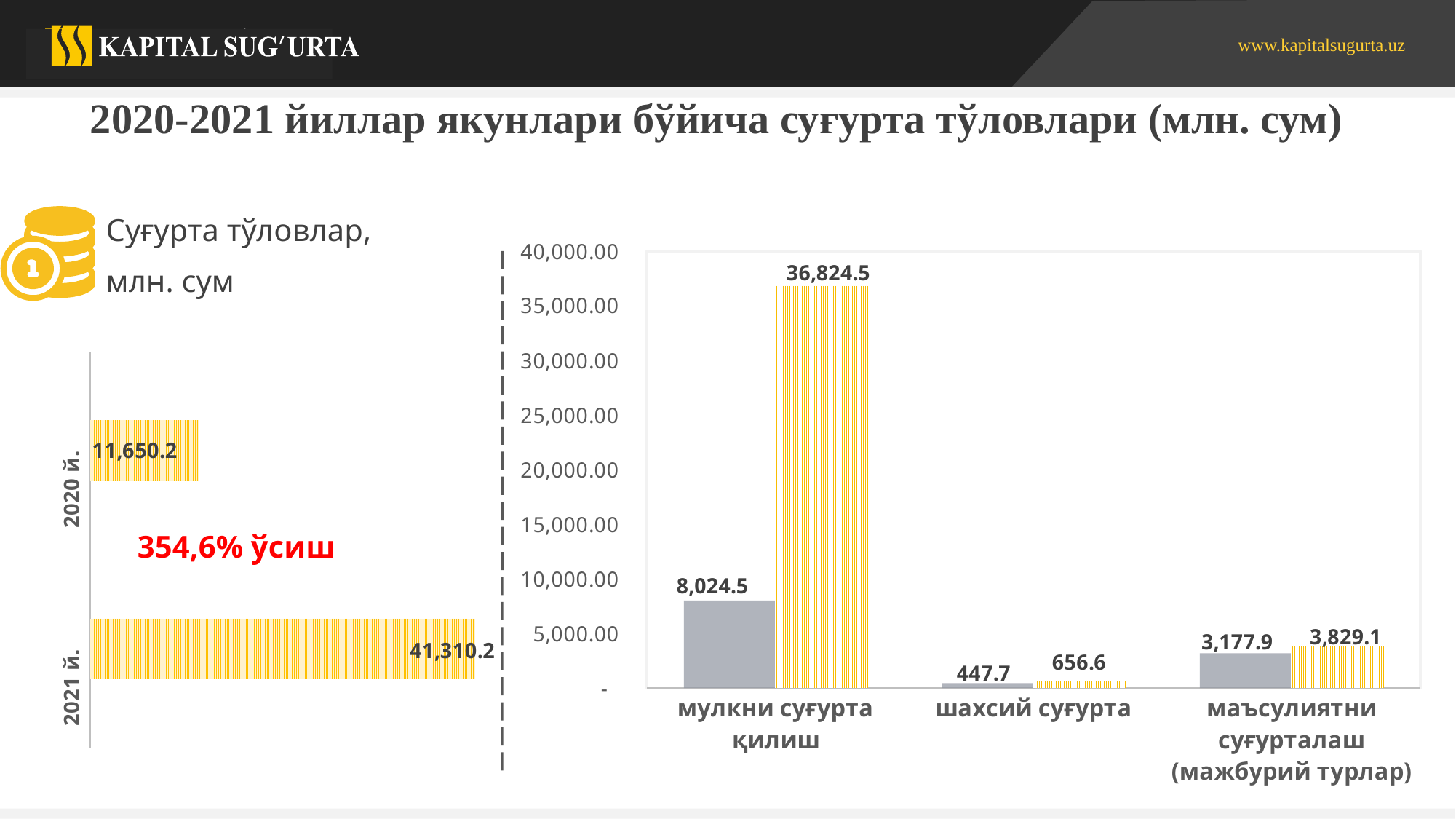
In the right chart, what is the value of the yellow bar for маъсулиятни суғурталаш (мажбурий турлар)? 3,829.1 In the left chart, what is the difference between the 2021 й. and 2020 й. values? 29,660.0 In the left chart, what is the value for 2020 й.? 11,650.2 How many categories are shown on the x axis of the right chart? 3 In the right chart, what is the difference between the yellow and grey bars for мулкни суғурта қилиш? 28,800.0 In the right chart, which category has the highest value? мулкни суғурта қилиш In the right chart, which category has the lowest value? шахсий суғурта What kind of chart is the left chart? bar chart In the right chart, what is the value of the grey bar for шахсий суғурта? 447.7 In the right chart, what is the value of the yellow bar for мулкни суғурта қилиш? 36,824.5 In the right chart, is the grey bar for маъсулиятни суғурталаш (мажбурий турлар) larger or smaller than the yellow bar for the same category? smaller In the left chart, what is the value for 2021 й.? 41,310.2